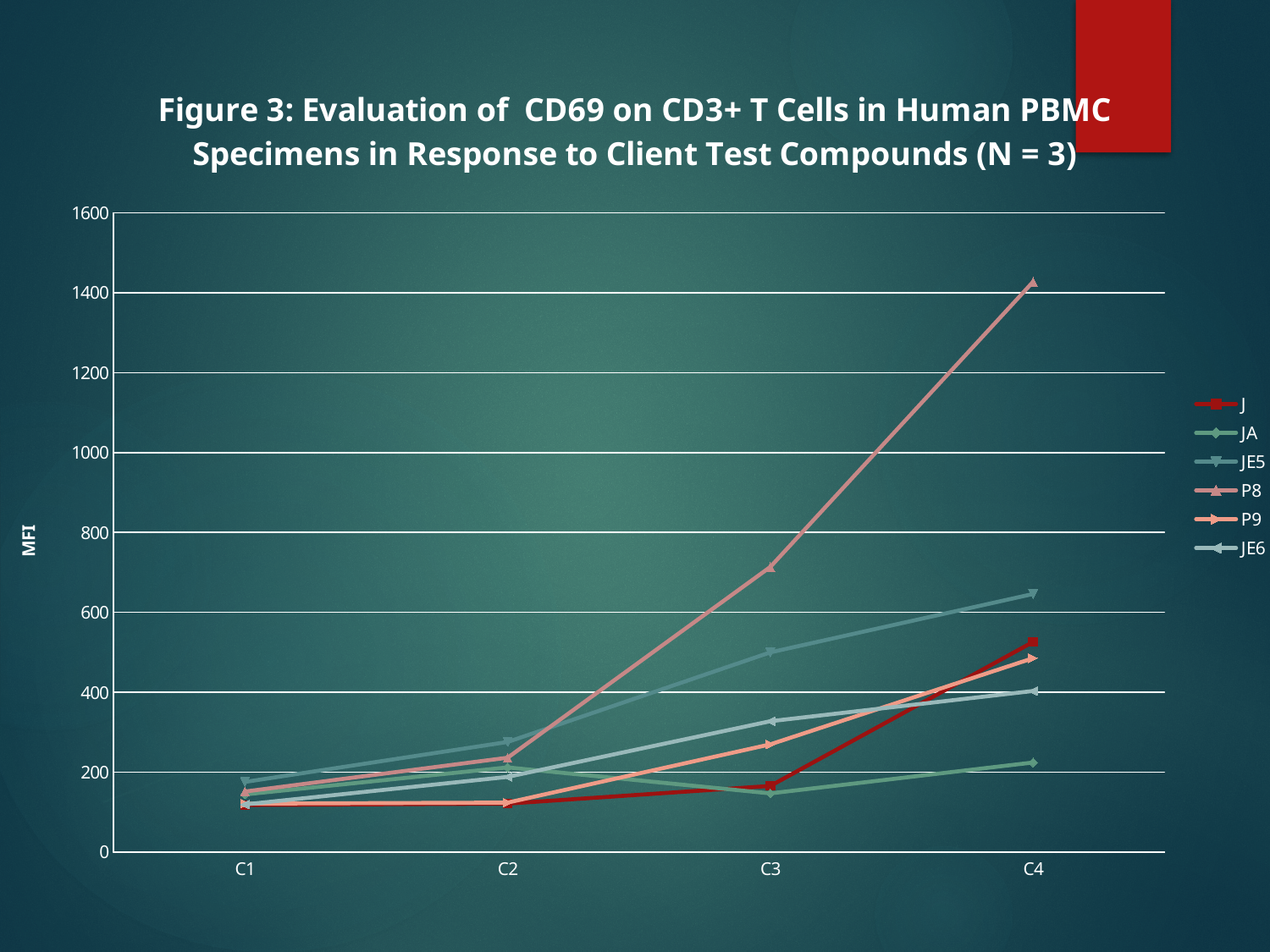
How many series does the legend list? 6 Is the value for P8 at C3 greater or less than 600? greater Is the value for P8 at C4 greater or less than 1200? greater What is the label on the y axis? MFI Which series has the highest value at C4? P8 Is the value for JE5 at C4 greater or less than 600? greater At C3, which series has the larger value, P8 or JE5? P8 Which series has the lowest value at C4? JA How many categories are shown on the x axis? 4 Does the P8 series rise or fall from C1 to C4? rise What kind of chart is shown on the slide? line chart